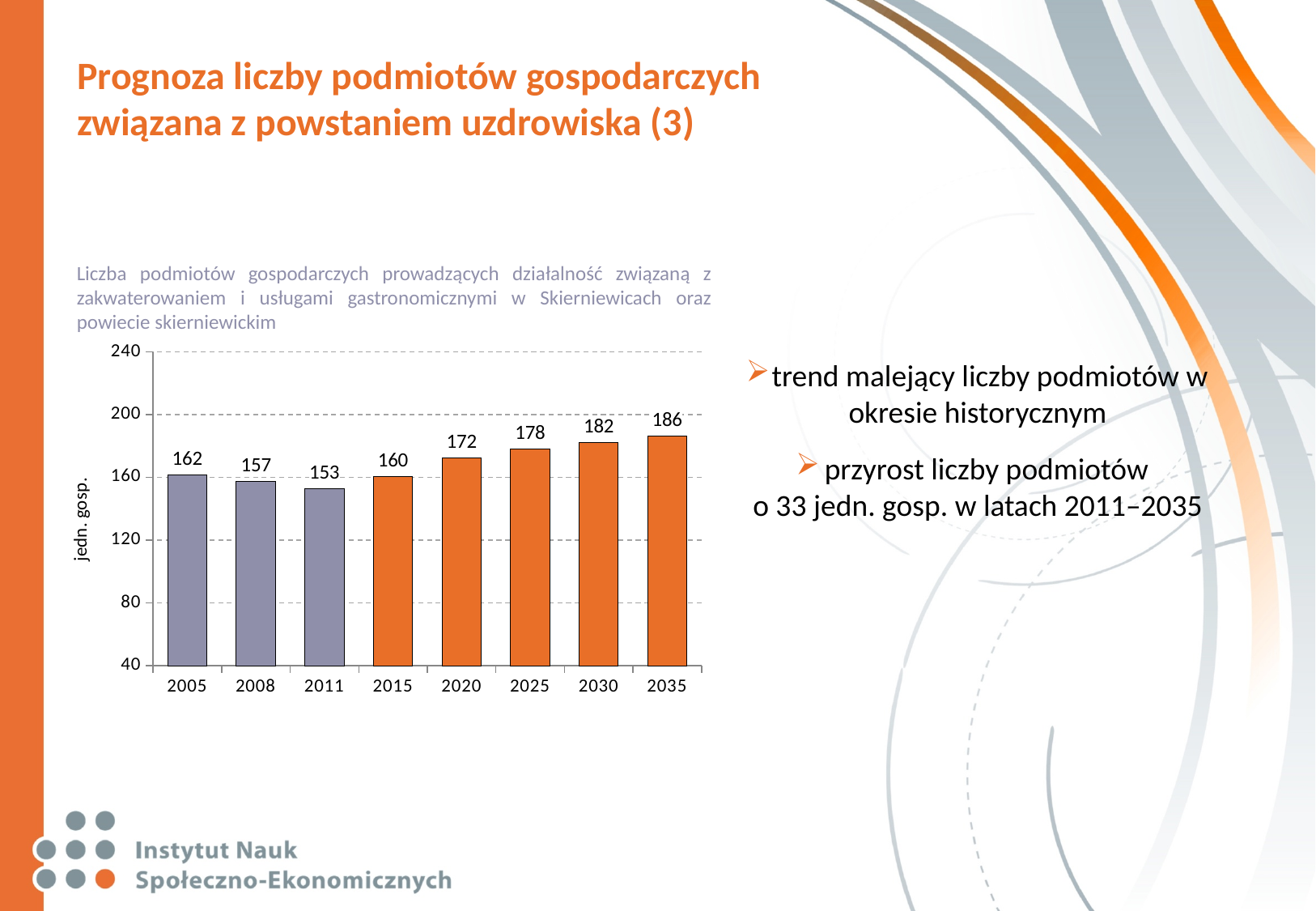
Which is larger, the value for 2008 or the value for 2015? 2015 Is the value for 2030 greater or less than 160? greater What is the label of the y axis? jedn. gosp. What colour are the bars for 2005, 2008 and 2011? grey-purple Do the values rise or fall from 2011 to 2035? rise What is the value for 2020? 172 Which year has the lowest value? 2011 What is the value for 2005? 162 What is the difference between the values for 2035 and 2011? 33 How many years are shown on the x axis? 8 What kind of chart is shown? bar chart Which year has the highest value? 2035